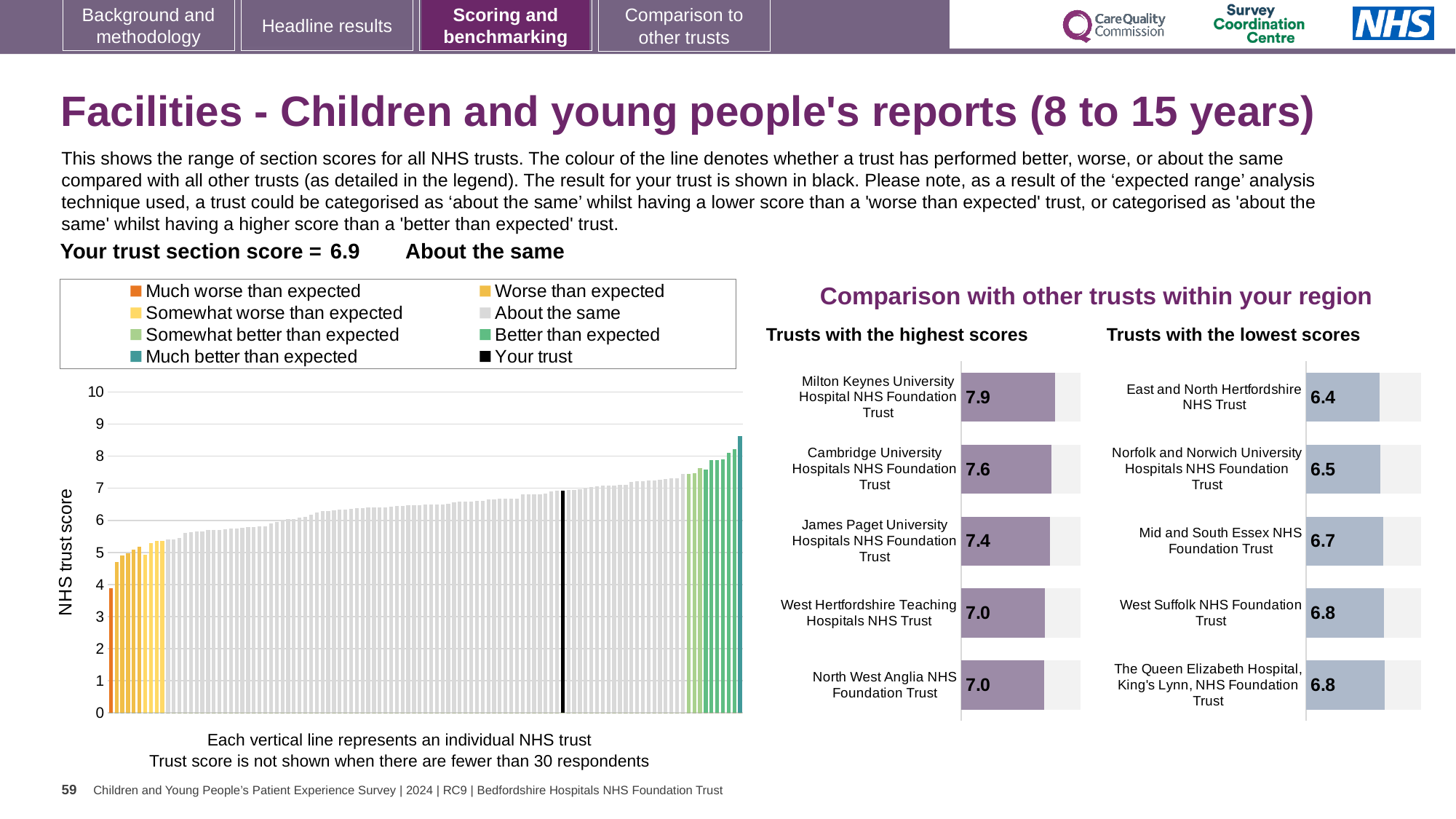
In the 'Trusts with the lowest scores' chart, what is the score for Norfolk and Norwich University Hospitals NHS Foundation Trust? 6.5 In the 'Trusts with the highest scores' chart, what is the difference between the scores of Milton Keynes University Hospital NHS Foundation Trust and Cambridge University Hospitals NHS Foundation Trust? 0.3 How many trusts are shown in the 'Trusts with the highest scores' chart? 5 How many entries does the legend of the main chart on the left list? 8 In the main chart on the left showing the range of section scores, is the value of the leftmost (lowest) bar greater or less than 5? less In the main chart on the left showing the range of section scores, do the bar values rise or fall from left to right? rise In the 'Trusts with the lowest scores' chart, what is the difference between the scores of West Suffolk NHS Foundation Trust and East and North Hertfordshire NHS Trust? 0.4 In the 'Trusts with the highest scores' chart, what is the score for James Paget University Hospitals NHS Foundation Trust? 7.4 In the 'Trusts with the highest scores' chart, what is the score for Milton Keynes University Hospital NHS Foundation Trust? 7.9 In the 'Trusts with the highest scores' chart, which trust has the highest score? Milton Keynes University Hospital NHS Foundation Trust In the 'Trusts with the lowest scores' chart, which trust has the lowest score? East and North Hertfordshire NHS Trust In the 'Trusts with the lowest scores' chart, which has the higher score: Mid and South Essex NHS Foundation Trust or Norfolk and Norwich University Hospitals NHS Foundation Trust? Mid and South Essex NHS Foundation Trust